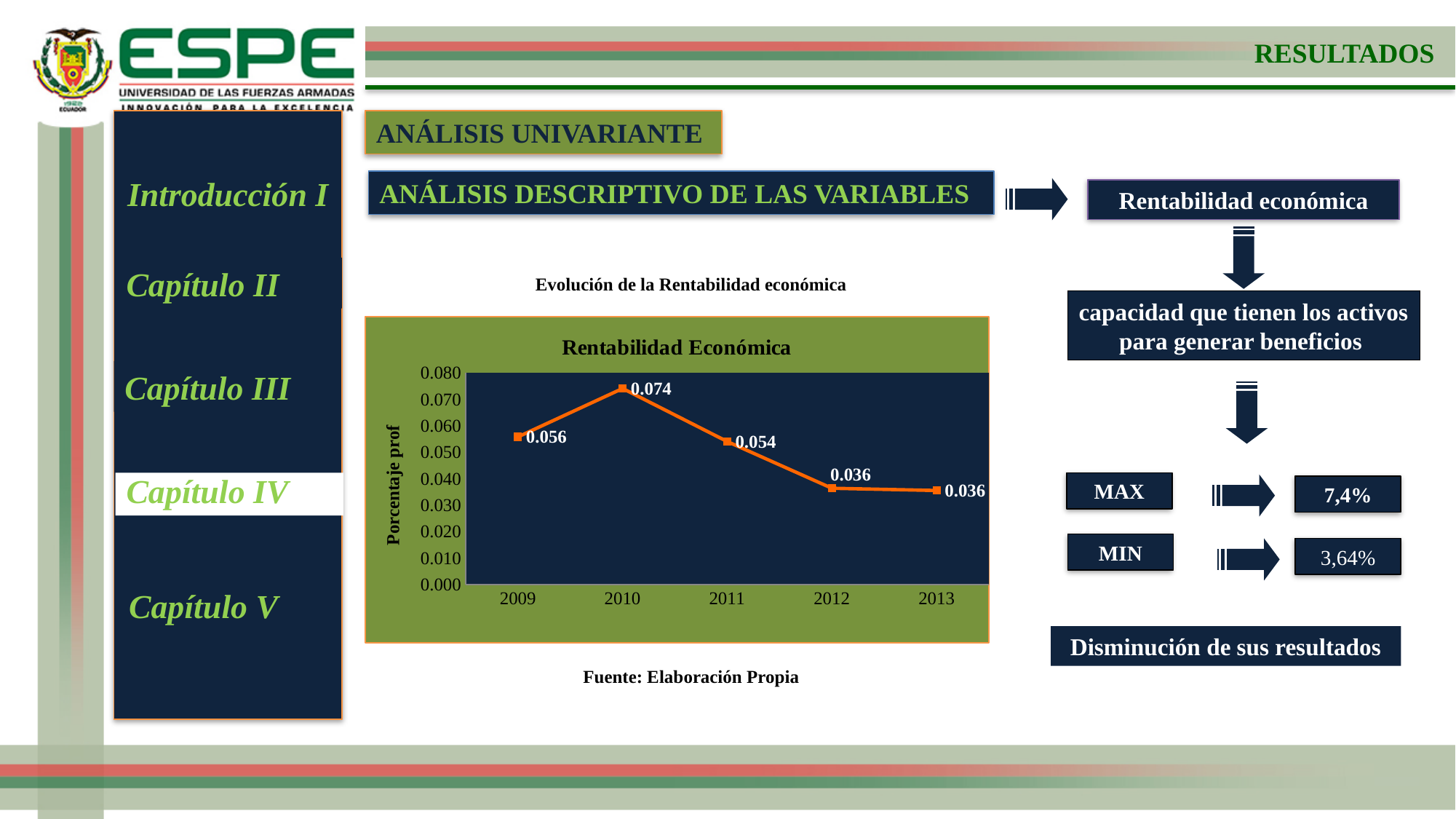
Which year has the highest value in the Rentabilidad Económica chart? 2010 What is the value for 2011 in the Rentabilidad Económica chart? 0.054 What kind of chart is the Rentabilidad Económica chart? line chart Which is larger in the Rentabilidad Económica chart, the value for 2009 or the value for 2011? 2009 What is the title of the chart on the slide? Rentabilidad Económica What is the value for 2013 in the Rentabilidad Económica chart? 0.036 What is the difference between the values for 2009 and 2012 in the Rentabilidad Económica chart? 0.020 Do the values in the Rentabilidad Económica chart rise or fall from 2010 to 2013? fall What is the value for 2010 in the Rentabilidad Económica chart? 0.074 How many years are plotted in the Rentabilidad Económica chart? 5 What is the difference between the values for 2010 and 2011 in the Rentabilidad Económica chart? 0.020 What is the value for 2009 in the Rentabilidad Económica chart? 0.056